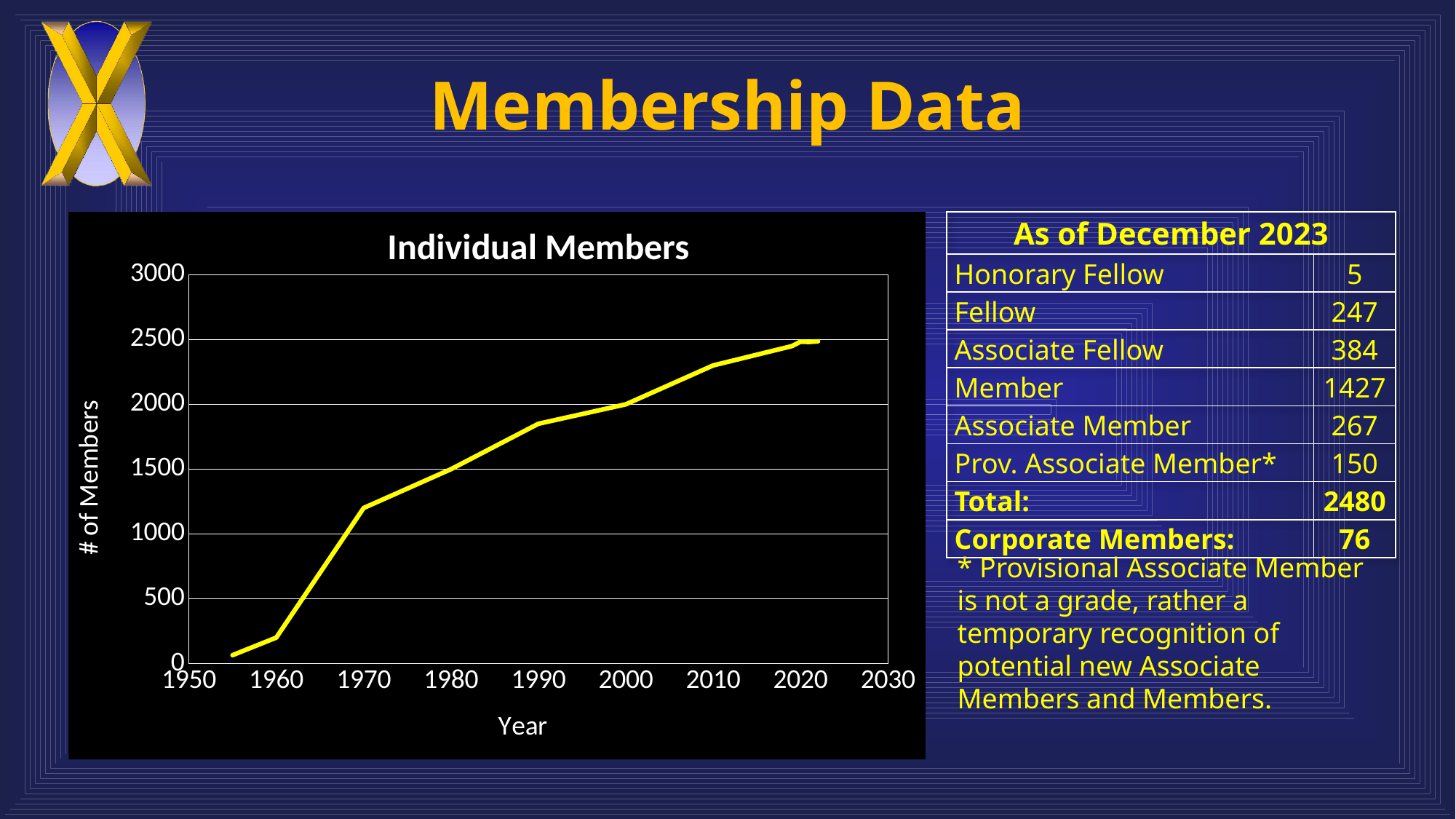
Is the value for 1970 greater or less than 1000? greater Is the value for 1990 greater or less than 1500? greater Is the value for 2020 greater or less than 3000? less Which year has the smaller value, 1960 or 1980? 1960 What is the title of the chart? Individual Members Do the values in the chart rise or fall as the year increases? rise What kind of chart is shown on the slide? line chart What is the label on the vertical axis of the chart? # of Members Which year has the larger value, 1990 or 2010? 2010